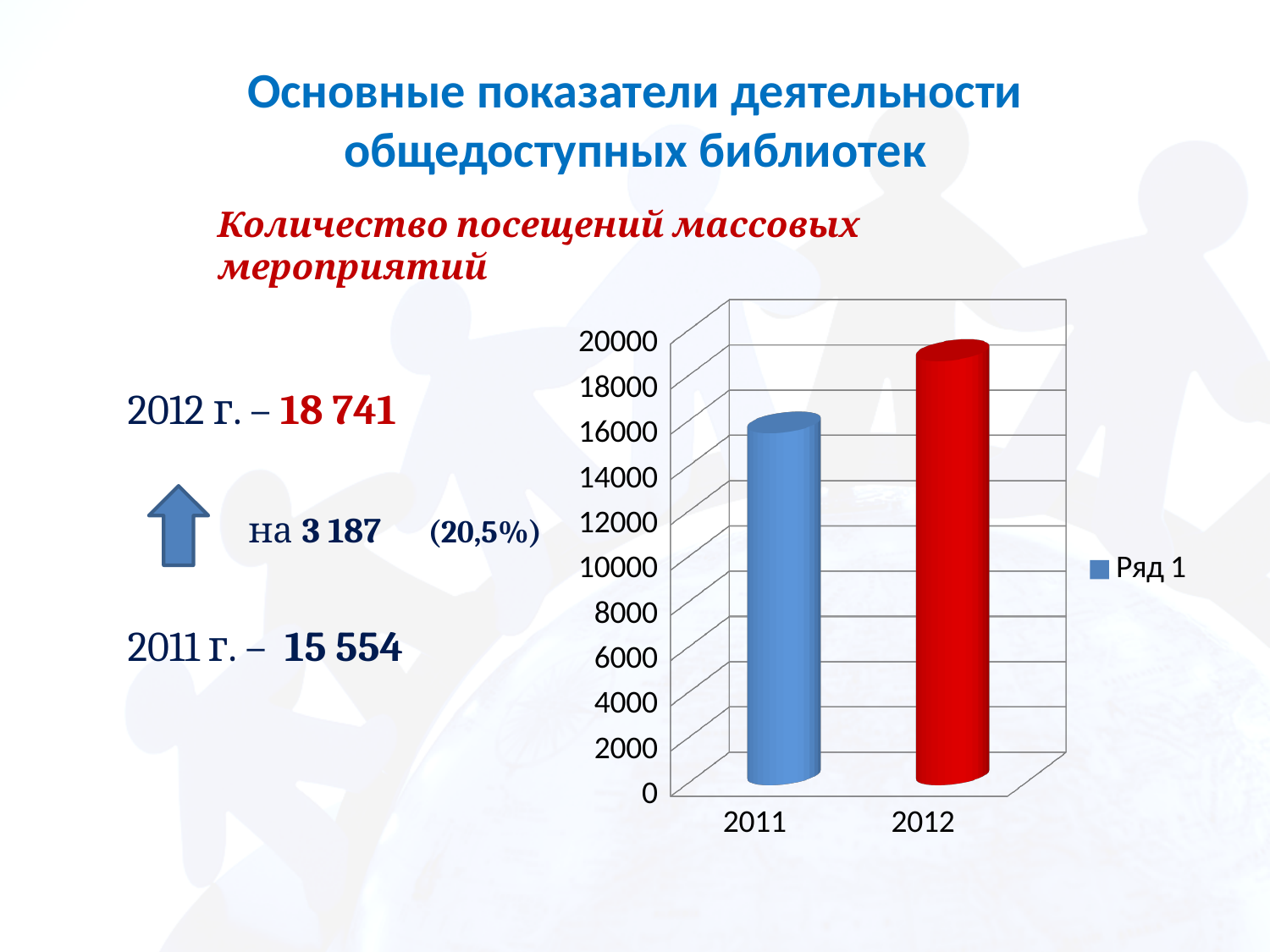
What is the name of the series in the chart legend? Ряд 1 Is the value for 2011 greater or less than 14000? greater What kind of chart is shown on the slide? bar chart Is the value for 2012 greater or less than 18000? greater How many categories are plotted on the x axis of the chart? 2 What colour is the bar for 2012? red Which year has the higher bar in the chart? 2012 Which year has the lower bar in the chart? 2011 Do the values rise or fall from 2011 to 2012? rise Is the value for 2012 greater or less than 20000? less How many series does the chart legend list? 1